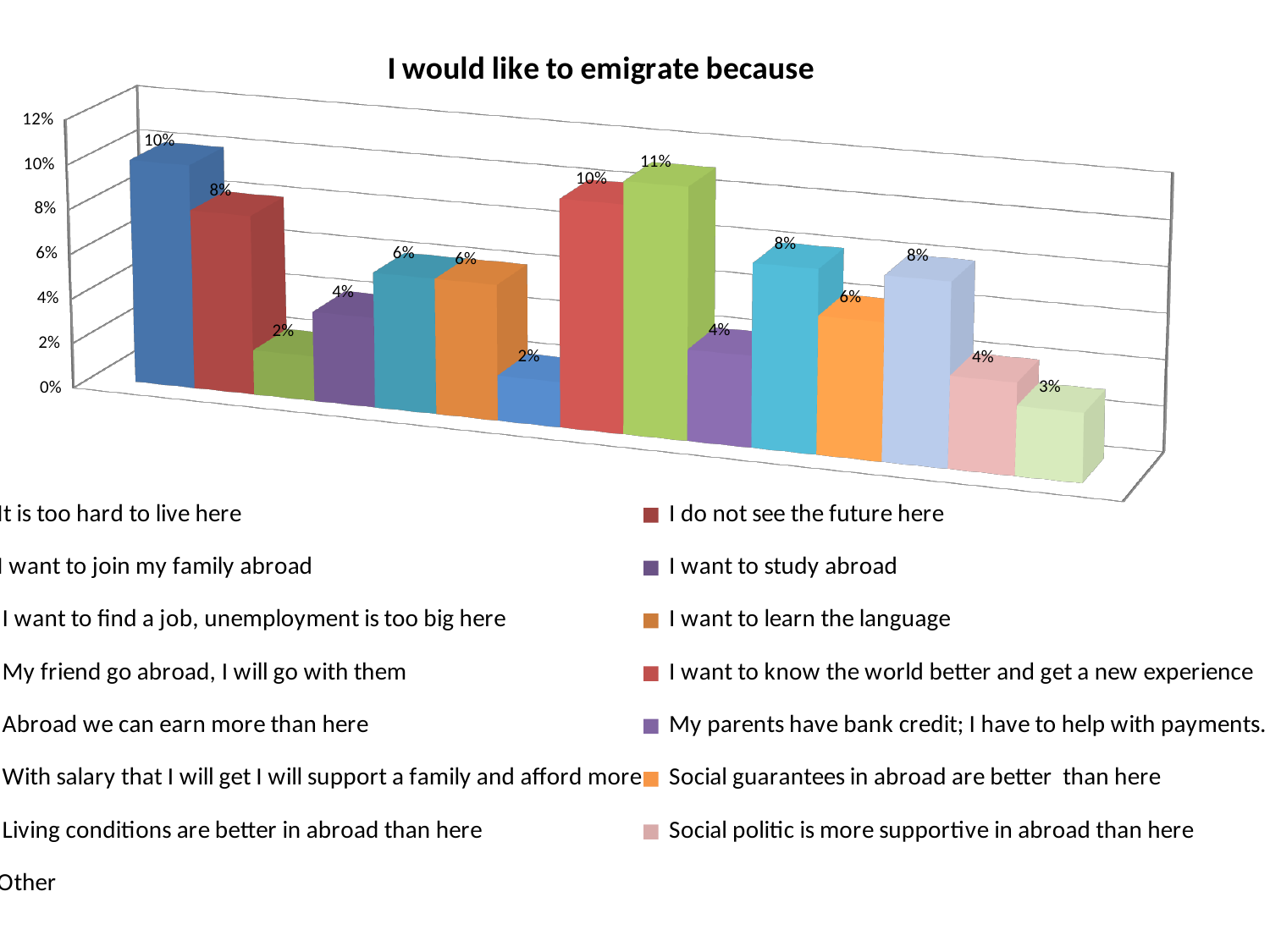
Which reason has the highest value in the chart? Abroad we can earn more than here What is the difference between the value for 'I do not see the future here' and the value for 'I want to study abroad'? 4% What is the value for 'Other'? 3% What is the value for 'I do not see the future here'? 8% How many bars are plotted in the chart? 15 How many entries does the legend list? 15 What is the value for 'I want to know the world better and get a new experience'? 10% What is the value for 'Social politic is more supportive in abroad than here'? 4% What is the title of the chart? I would like to emigrate because Which is larger: the value for 'I want to know the world better and get a new experience' or the value for 'Social guarantees in abroad are better than here'? I want to know the world better and get a new experience What is the value for 'I want to learn the language'? 6% What type of chart is shown on the slide? bar chart